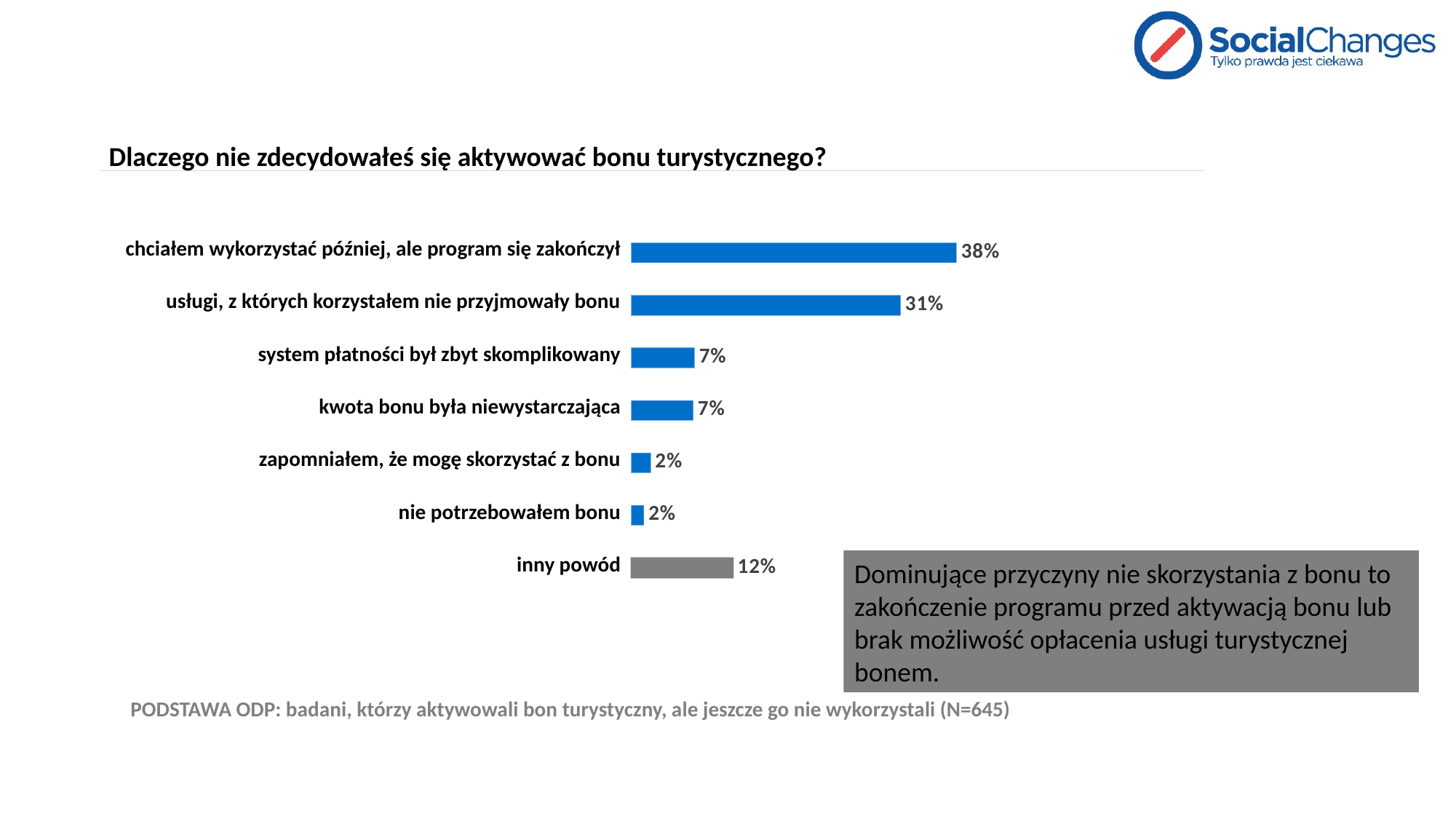
Which bar is coloured grey instead of blue? inny powód What is the difference between the values for "chciałem wykorzystać później, ale program się zakończył" and "usługi, z których korzystałem nie przyjmowały bonu"? 7% How many categories are shown in the chart? 7 What is the difference between the values for "inny powód" and "nie potrzebowałem bonu"? 10% Which category has the highest value? chciałem wykorzystać później, ale program się zakończył What kind of chart is shown on the slide? bar chart Which is larger: the value for "inny powód" or the value for "kwota bonu była niewystarczająca"? inny powód What is the value for "usługi, z których korzystałem nie przyjmowały bonu"? 31% What is the value for "system płatności był zbyt skomplikowany"? 7% What is the value for "inny powód"? 12% What is the title of the chart? Dlaczego nie zdecydowałeś się aktywować bonu turystycznego? What is the value for "chciałem wykorzystać później, ale program się zakończył"? 38%